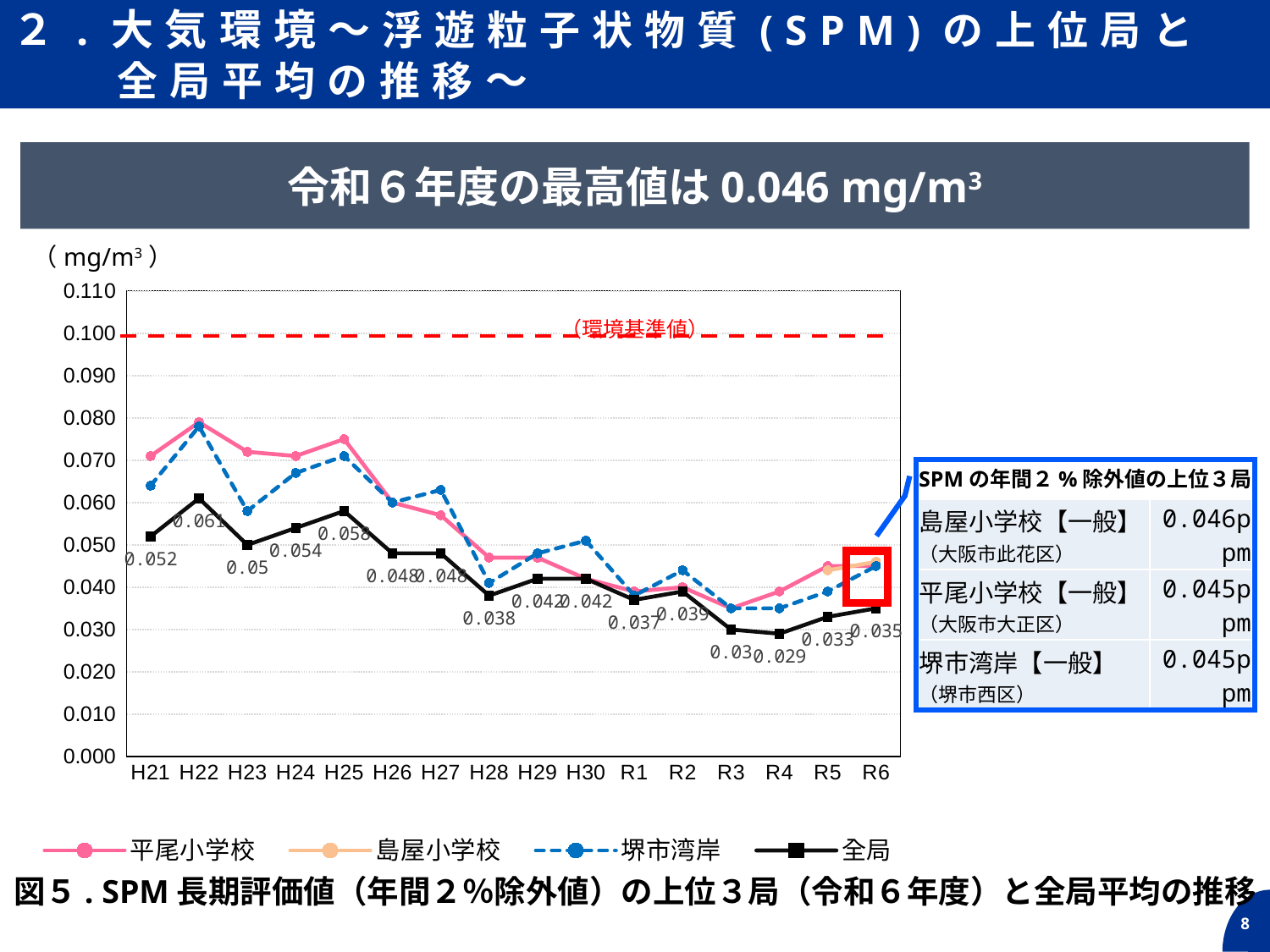
What is the value of 全局 in R4? 0.029 How many years (categories) are plotted along the x axis? 16 What is the value of 全局 in R6? 0.035 How many series does the chart legend list? 4 What is the value of 全局 in H22? 0.061 Which is larger, the 全局 value in H25 or in H26? H25 What kind of chart is shown on the slide? line chart At what level is the red dashed 環境基準値 line drawn? 0.100 In which year is the 全局 value lowest? R4 In which year is the 全局 value highest? H22 What is the difference between the 全局 values in H22 and R4? 0.032 Is the value for 平尾小学校 in H22 greater or less than 0.070? greater